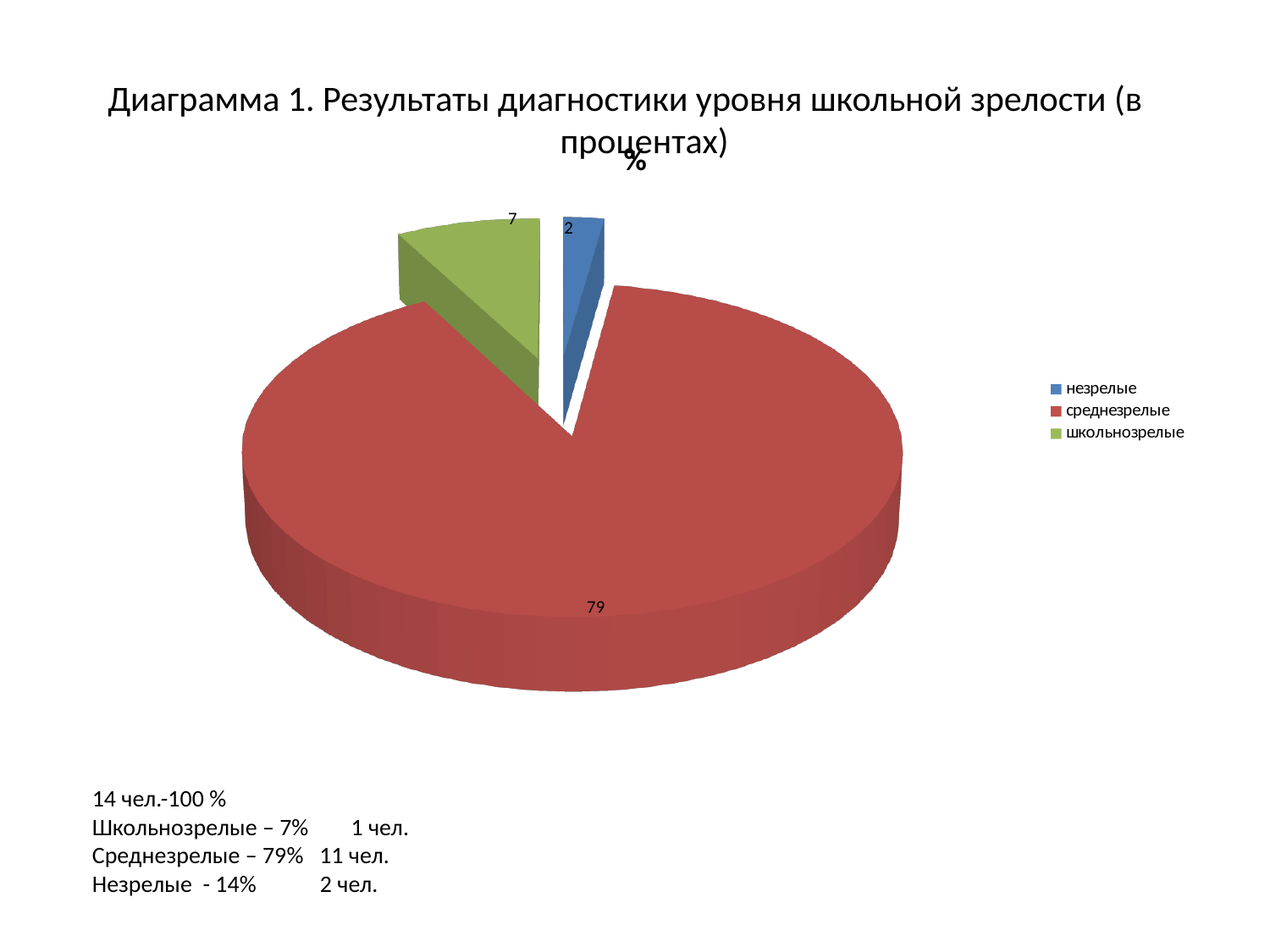
How many entries are listed in the legend? 3 What is the data label for the незрелые slice? 2 What colour is the среднезрелые slice? red What is the data label for the среднезрелые slice? 79 What is the data label for the школьнозрелые slice? 7 Which category has the largest slice of the pie? среднезрелые What type of chart is shown on the slide? pie chart Which category has the smallest slice of the pie? незрелые What is the difference between the data labels for школьнозрелые and незрелые? 5 How many categories does the pie chart show? 3 Which slice is larger, школьнозрелые or незрелые? школьнозрелые What is the difference between the data labels for среднезрелые and школьнозрелые? 72